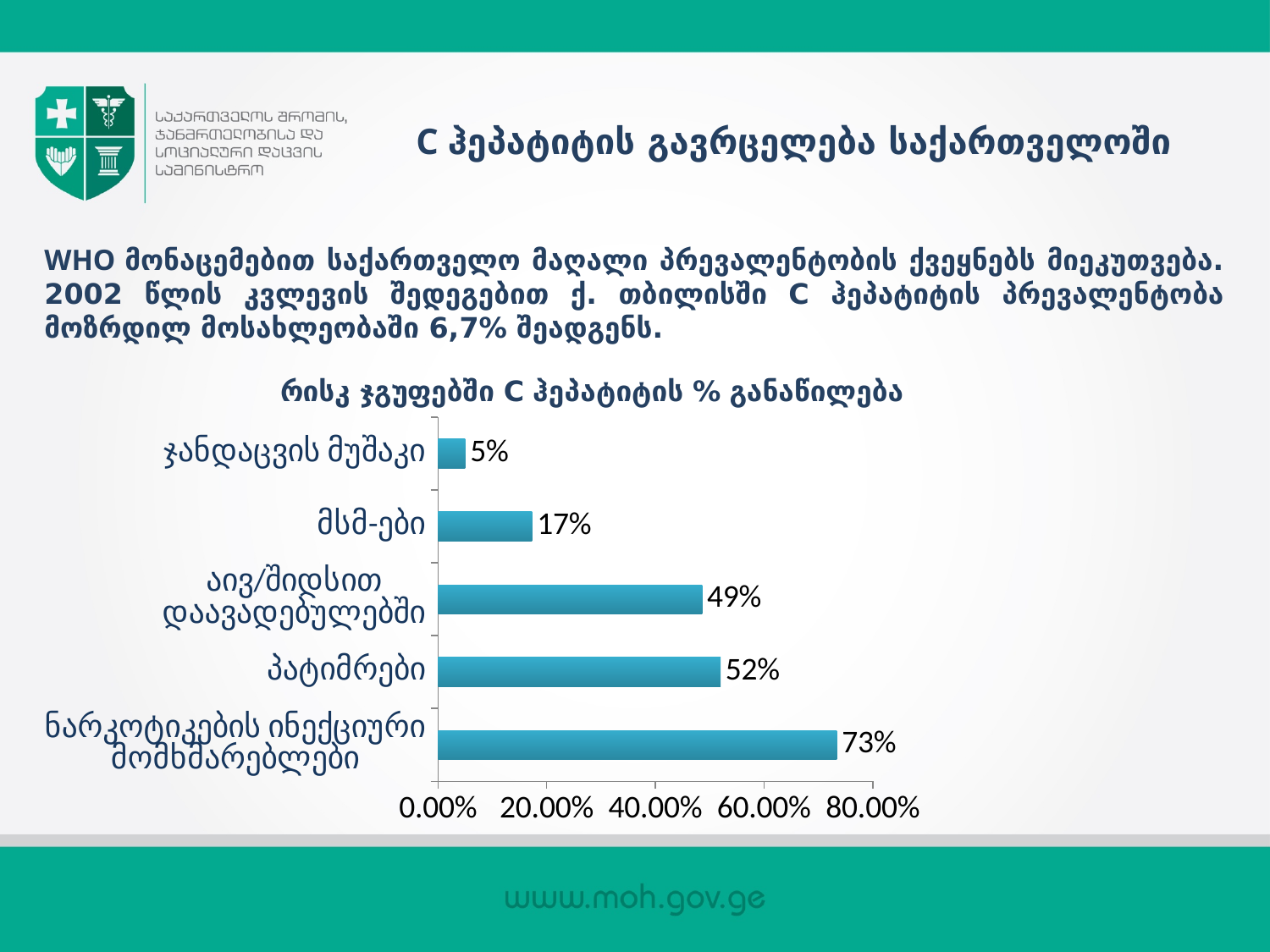
What is the value for მსმ-ები? 17% What is the value for პატიმრები? 52% How many categories are shown in the chart? 5 Is the value for აივ/შიდსით დაავადებულებში greater or less than 40.00%? greater What is the value for ნარკოტიკების ინექციური მომხმარებლები? 73% What is the title of the chart? რისკ ჯგუფებში C ჰეპატიტის % განაწილება What kind of chart is shown on the slide? bar chart What is the difference between the values for ნარკოტიკების ინექციური მომხმარებლები and პატიმრები? 21% Which category has the highest value? ნარკოტიკების ინექციური მომხმარებლები What is the value for ჯანდაცვის მუშაკი? 5% Which category has the lowest value? ჯანდაცვის მუშაკი Which is larger, the value for მსმ-ები or the value for აივ/შიდსით დაავადებულებში? აივ/შიდსით დაავადებულებში